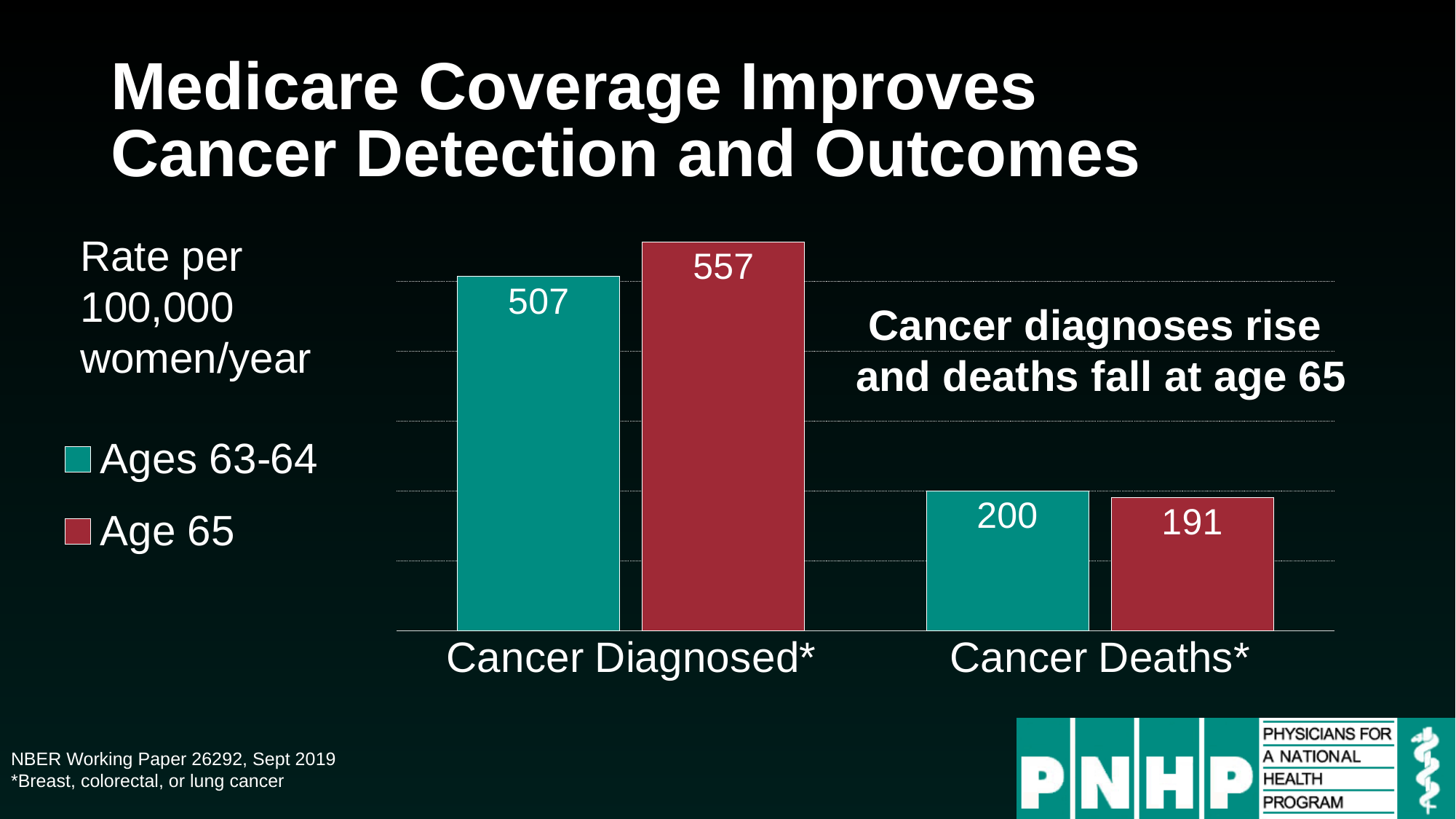
Which age group has the lower cancer deaths rate? Age 65 What is the cancer diagnosed rate for age 65? 557 Which colour represents the Age 65 series? Red What is the difference between the cancer diagnosed rates for age 65 and ages 63-64? 50 What is the cancer diagnosed rate for ages 63-64? 507 Which age group has the higher cancer diagnosed rate? Age 65 How many categories are shown on the x axis? 2 How many series does the legend list? 2 What is the cancer deaths rate for age 65? 191 What kind of chart is shown on the slide? Bar chart What is the difference between the cancer deaths rates for ages 63-64 and age 65? 9 What is the cancer deaths rate for ages 63-64? 200